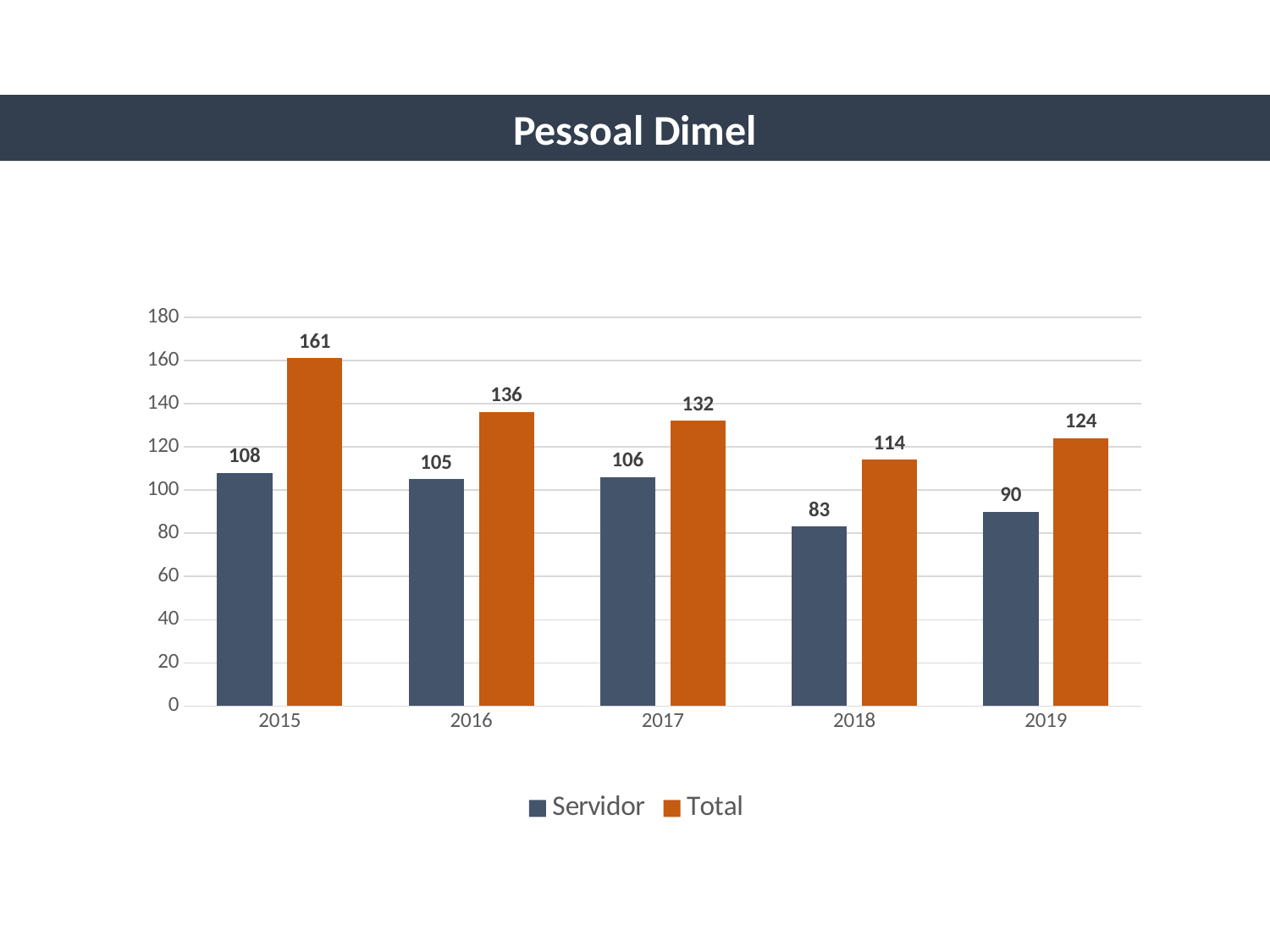
How many years are shown on the x axis? 5 Which year has the lowest Servidor value? 2018 How many series does the legend list? 2 What is the Servidor value for 2015? 108 What is the Total value for 2019? 124 What is the Total value for 2018? 114 What is the difference between the Total and Servidor values in 2016? 31 What is the difference between the Total values for 2015 and 2017? 29 What kind of chart is shown on the slide? bar chart Which is larger, the Servidor value for 2017 or the Servidor value for 2019? 2017 Which year has the highest Total value? 2015 What is the title of the slide? Pessoal Dimel